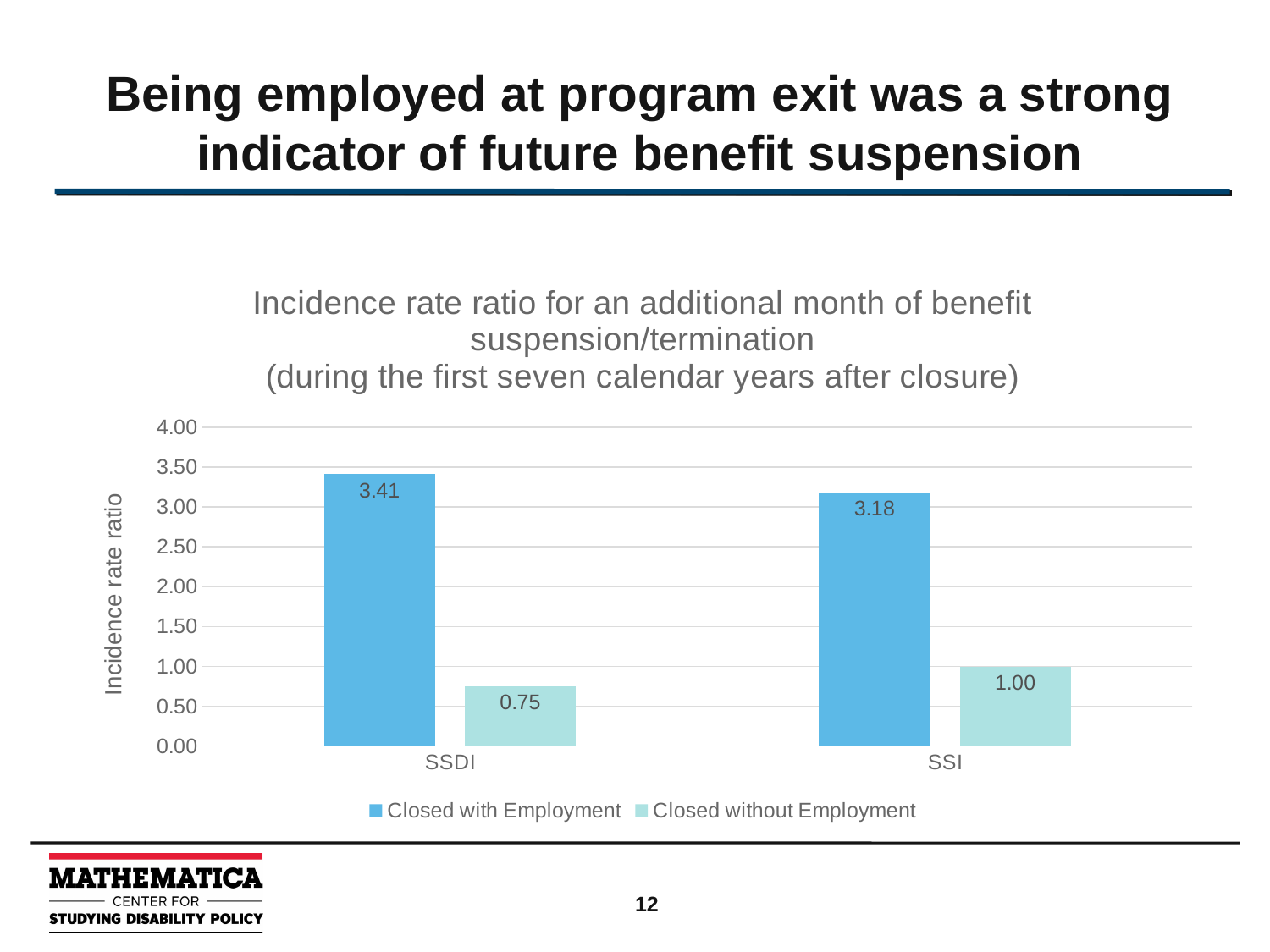
What is the difference between the Closed with Employment and Closed without Employment values for SSDI? 2.66 How many series does the legend list? 2 What is the incidence rate ratio for SSI in the Closed with Employment series? 3.18 Which category has the highest value in the Closed with Employment series? SSDI What is the incidence rate ratio for SSI in the Closed without Employment series? 1.00 Which is larger for SSI: Closed with Employment or Closed without Employment? Closed with Employment What is the incidence rate ratio for SSDI in the Closed with Employment series? 3.41 How many categories are shown on the x axis? 2 What is the incidence rate ratio for SSDI in the Closed without Employment series? 0.75 What is the difference between the Closed with Employment values for SSDI and SSI? 0.23 What kind of chart is shown on the slide? Bar chart Which category has the lowest value in the Closed without Employment series? SSDI